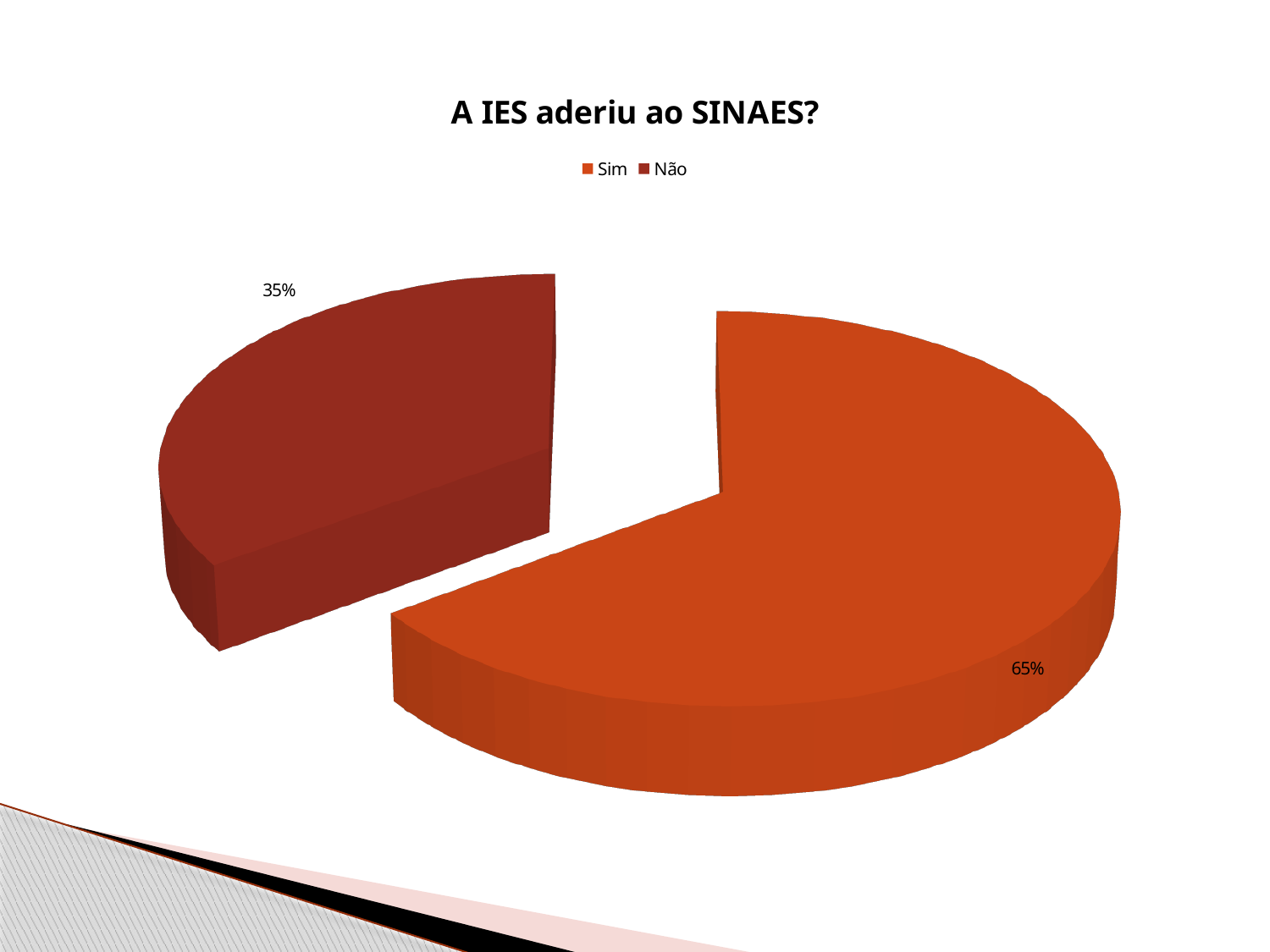
What percentage of the pie is labelled "Não"? 35% Which slice is the largest? Sim What percentage of the pie is labelled "Sim"? 65% Which is larger, the "Sim" slice or the "Não" slice? Sim What is the title of the chart? A IES aderiu ao SINAES? Which legend entry is shown in the darker red colour? Não How many slices does the pie chart have? 2 What is the difference in percentage points between the "Sim" and "Não" slices? 30 How many entries does the legend list? 2 What share of the pie does the "Sim" slice represent? 65% What kind of chart is shown on the slide? pie chart Which slice is the smallest? Não